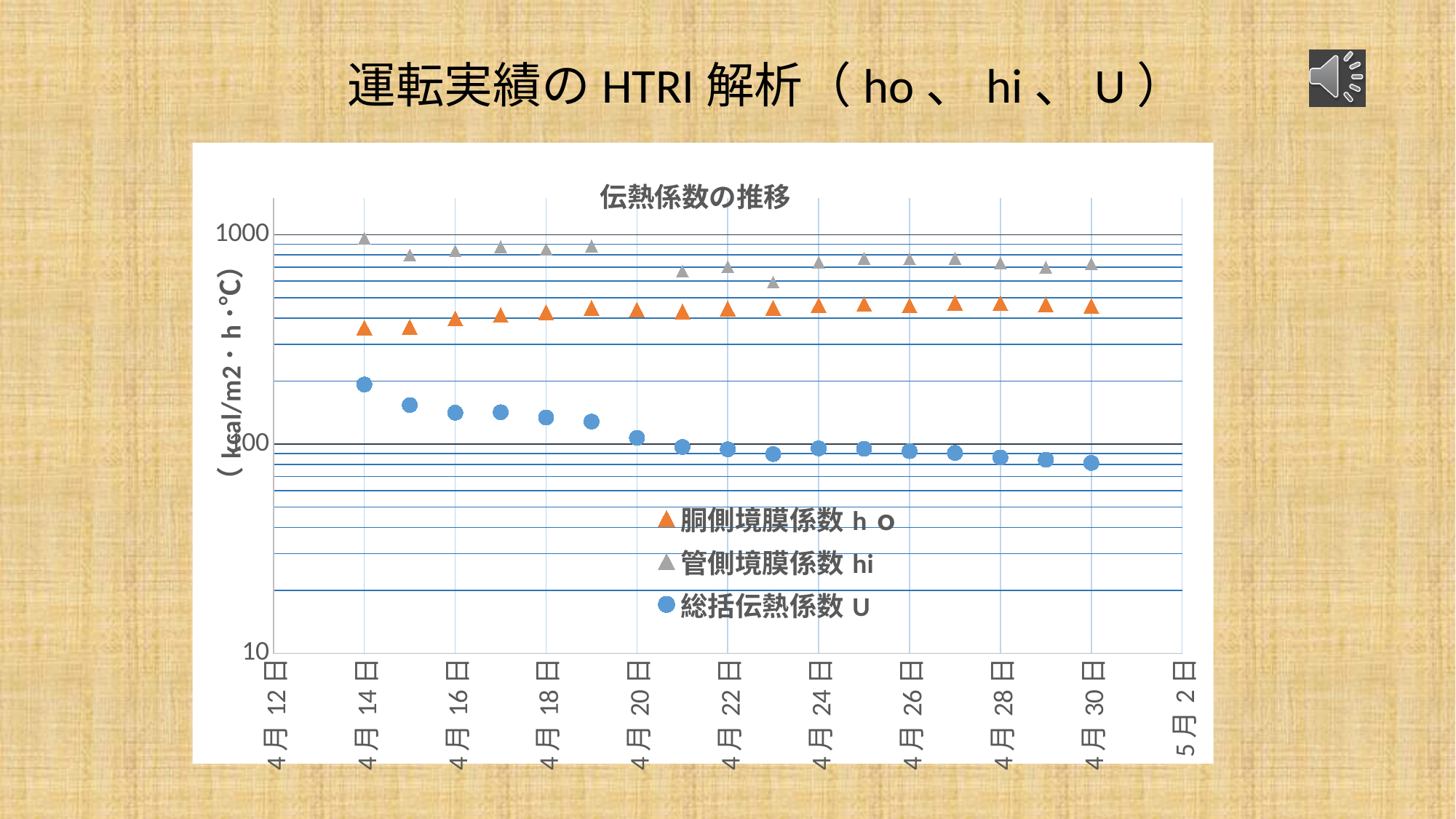
How many series does the legend list? 3 Is the value of 総括伝熱係数 U on 4月14日 greater or less than 100? greater Do the values of 胴側境膜係数ｈｏ rise or fall from 4月14日 to 4月30日? rise Do the values of 総括伝熱係数 U rise or fall from 4月14日 to 4月30日? fall What kind of chart is shown on the slide? scatter chart Which series has the highest values across the plotted dates? 管側境膜係数 hi What is the title of the chart? 伝熱係数の推移 Is the value of 胴側境膜係数ｈｏ on 4月14日 greater or less than 100? greater What unit is shown on the y-axis label? kcal/m2・h・℃ How many data points are plotted for 総括伝熱係数 U? 17 Is the value of 総括伝熱係数 U on 4月30日 greater or less than 100? less